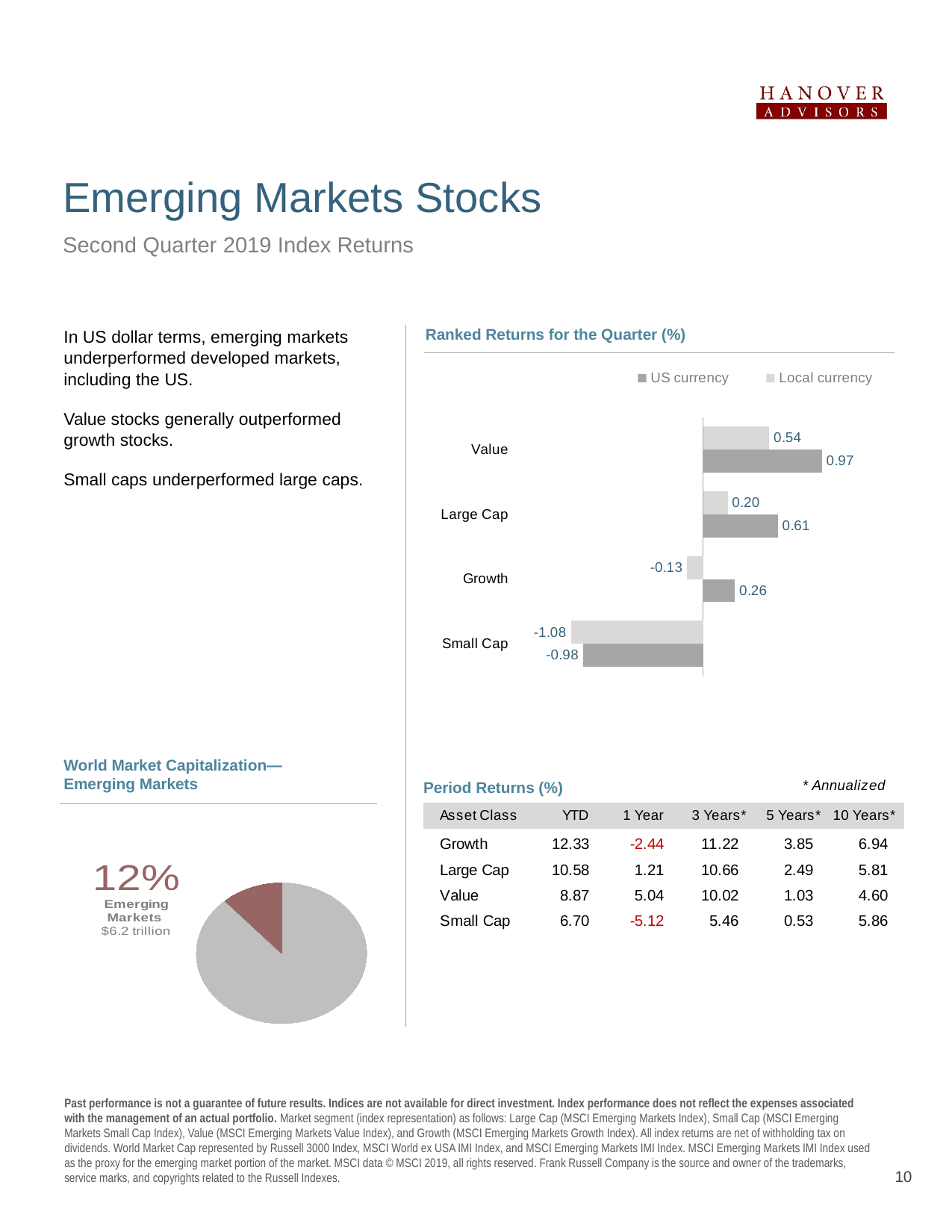
What kind of chart is the Ranked Returns for the Quarter (%) chart? Bar chart In the Ranked Returns for the Quarter (%) chart, what is the US currency return for Value? 0.97 In the Ranked Returns for the Quarter (%) chart, what is the difference between the US currency and Local currency returns for Large Cap? 0.41 What kind of chart is the World Market Capitalization—Emerging Markets chart? Pie chart In the Ranked Returns for the Quarter (%) chart, what is the Local currency return for Growth? -0.13 In the Ranked Returns for the Quarter (%) chart, which is larger for Growth: the US currency return or the Local currency return? US currency In the Ranked Returns for the Quarter (%) chart, what is the Local currency return for Small Cap? -1.08 In the Ranked Returns for the Quarter (%) chart, which category has the lowest Local currency return? Small Cap In the World Market Capitalization—Emerging Markets chart, what share of the pie do Emerging Markets represent? 12% How many series does the legend of the Ranked Returns for the Quarter (%) chart list? 2 In the Ranked Returns for the Quarter (%) chart, which category has the highest US currency return? Value How many categories are shown in the Ranked Returns for the Quarter (%) chart? 4